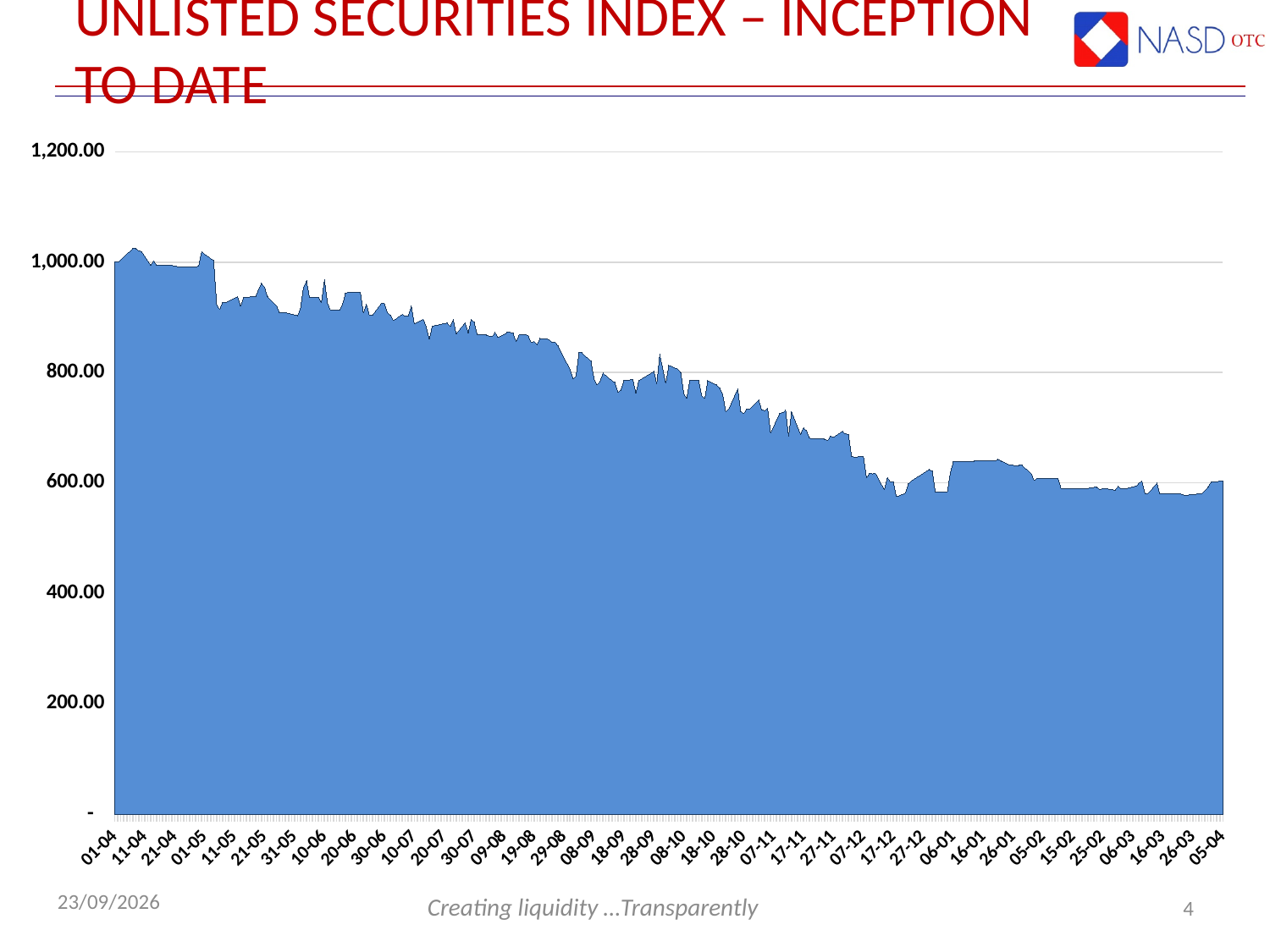
Is the value at 17-12 greater or less than 800? less Is the value at 20-06 greater or less than 800? greater Is the value at 05-04 greater or less than 400? greater Which is larger, the value at 01-04 or the value at 05-04? 01-04 What is the title of the chart on the slide? UNLISTED SECURITIES INDEX – INCEPTION TO DATE What kind of chart is shown on the slide? area chart Which is larger, the value at 01-05 or the value at 07-12? 01-05 Overall, do the values rise or fall from 01-04 to 05-04 along the x axis? fall What is the highest tick value shown on the y axis? 1,200.00